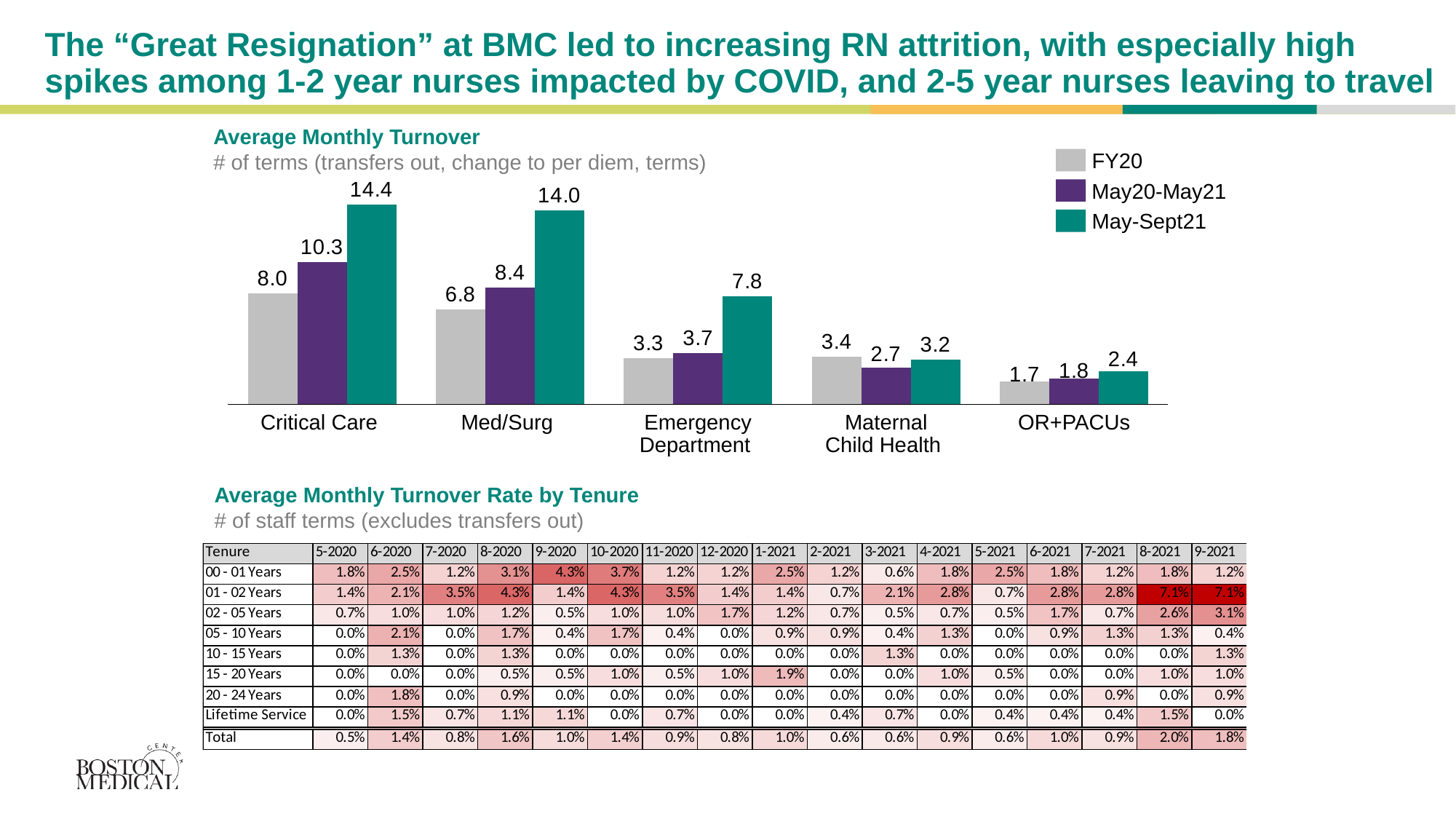
In the Average Monthly Turnover chart, which department has the highest May-Sept21 value? Critical Care In the Average Monthly Turnover chart, what is the May20-May21 value for Maternal Child Health? 2.7 In the Average Monthly Turnover chart, what is the difference between the May-Sept21 values for Critical Care and Med/Surg? 0.4 In the Average Monthly Turnover chart, what is the FY20 value for Med/Surg? 6.8 In the Average Monthly Turnover chart, which is larger for Maternal Child Health: the FY20 value or the May-Sept21 value? FY20 In the Average Monthly Turnover chart, which colour represents the May-Sept21 series? Teal In the Average Monthly Turnover chart, what is the difference between the May-Sept21 and FY20 values for Emergency Department? 4.5 How many departments are shown on the x axis of the Average Monthly Turnover chart? 5 How many series does the legend of the Average Monthly Turnover chart list? 3 In the Average Monthly Turnover chart, which department has the lowest FY20 value? OR+PACUs In the Average Monthly Turnover chart, what is the May-Sept21 value for Critical Care? 14.4 What kind of chart is the Average Monthly Turnover chart? Bar chart